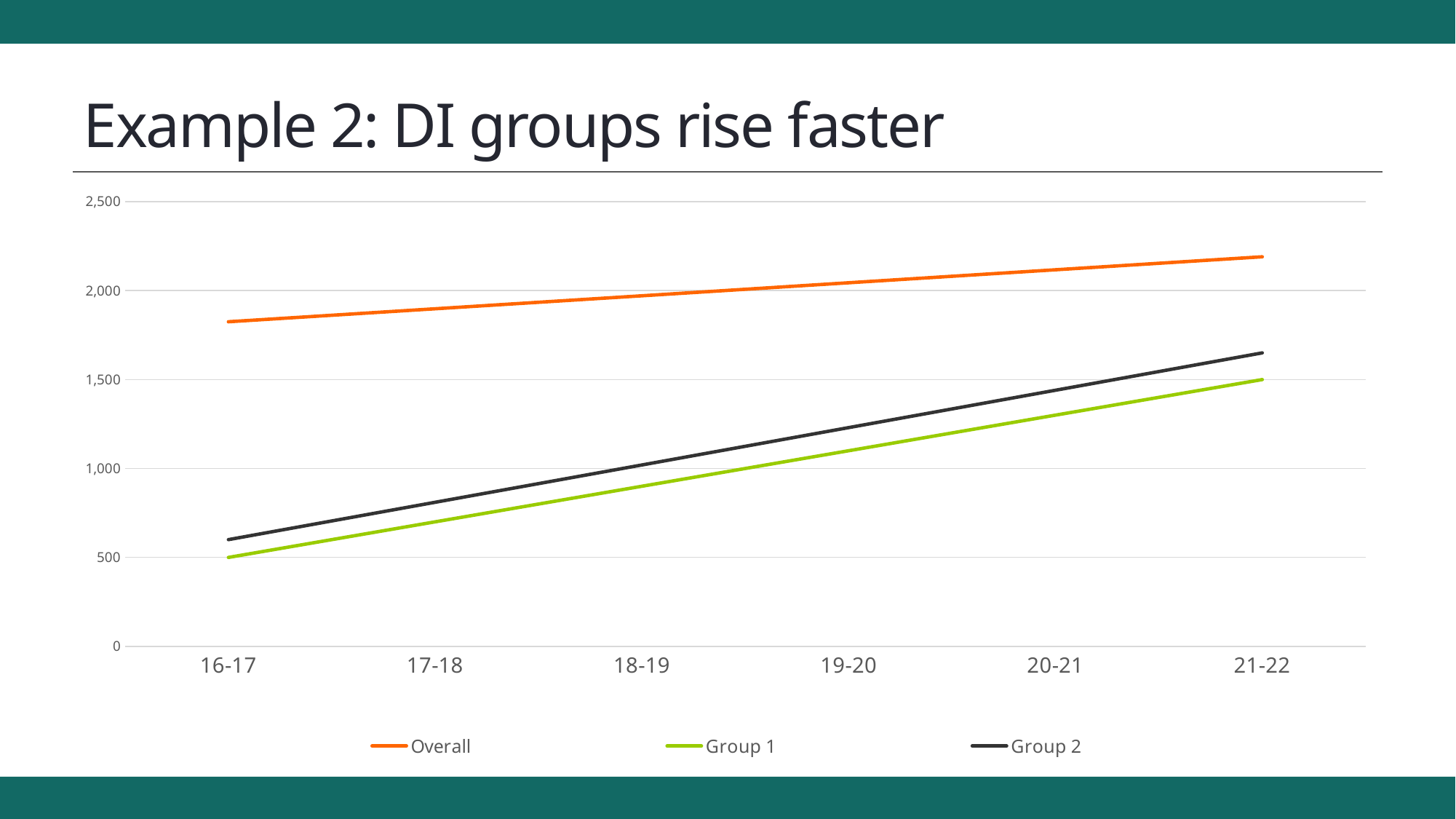
Do the values for Group 2 rise or fall from 16-17 to 21-22? rise Which series has the lowest value in 16-17? Group 1 What is the title of the slide? Example 2: DI groups rise faster What is the value for Group 1 in 21-22? 1,500 What kind of chart is shown on the slide? line chart What is the value for Group 1 in 16-17? 500 Is the value for Group 2 in 21-22 greater or less than 1,500? greater How many points are plotted along the x axis for each series? 6 Is the value for Overall in 21-22 greater or less than 2,000? greater How many series does the legend list? 3 Which series has the highest value in 21-22? Overall Is the value for Overall in 16-17 greater or less than 2,000? less